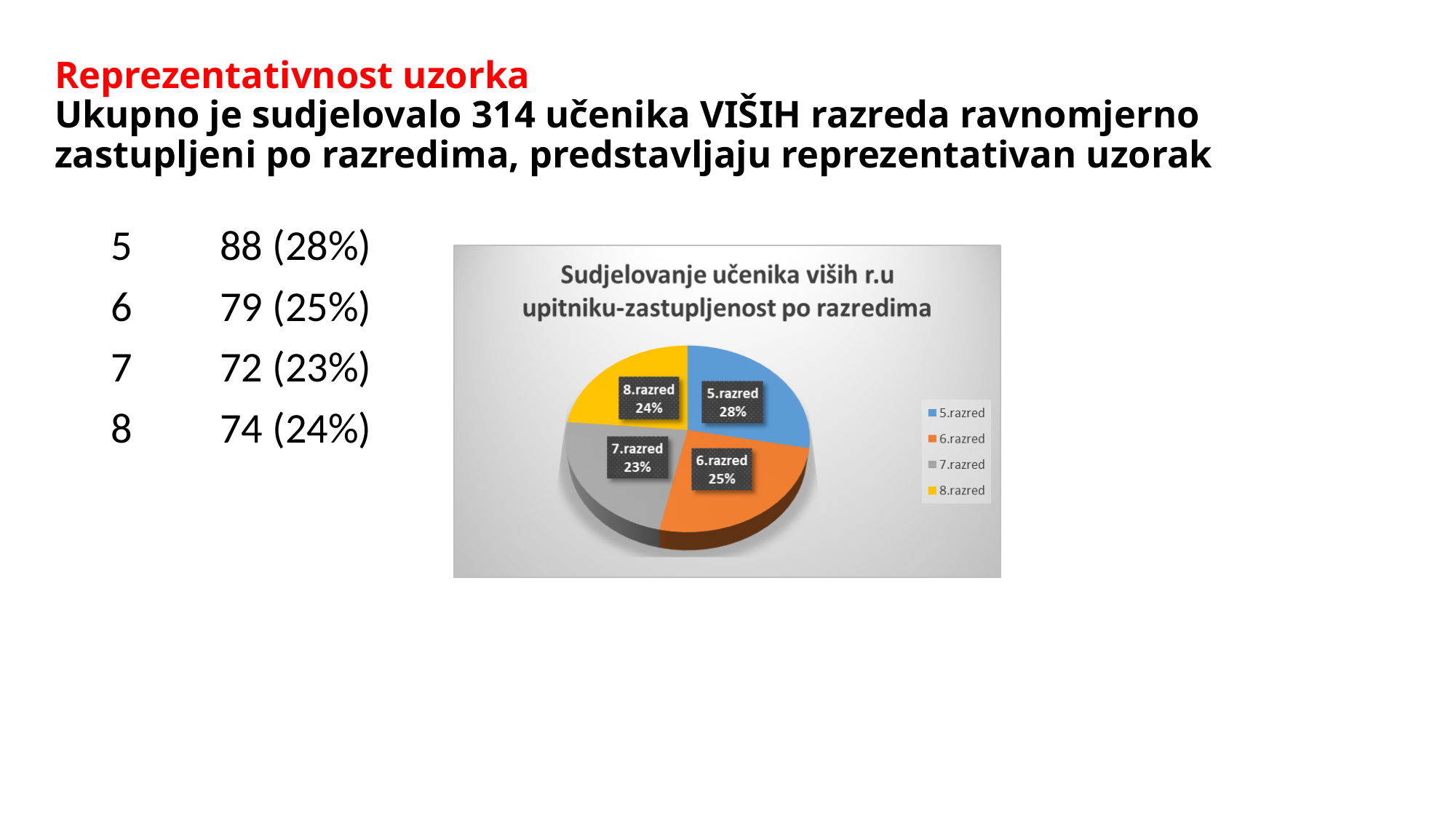
Which class has the largest slice in the pie chart? 5.razred What percentage share does the 8.razred slice have in the pie chart? 24% Which slice is larger, 6.razred or 8.razred? 6.razred How many slices does the pie chart have? 4 What percentage share does the 6.razred slice have in the pie chart? 25% What colour is the 8.razred slice in the pie chart? yellow What percentage share does the 7.razred slice have in the pie chart? 23% What percentage share does the 5.razred slice have in the pie chart? 28% What is the difference in percentage points between the 5.razred and 7.razred slices? 5 What kind of chart is shown on the slide? pie chart How many entries does the legend of the pie chart list? 4 Which class has the smallest slice in the pie chart? 7.razred